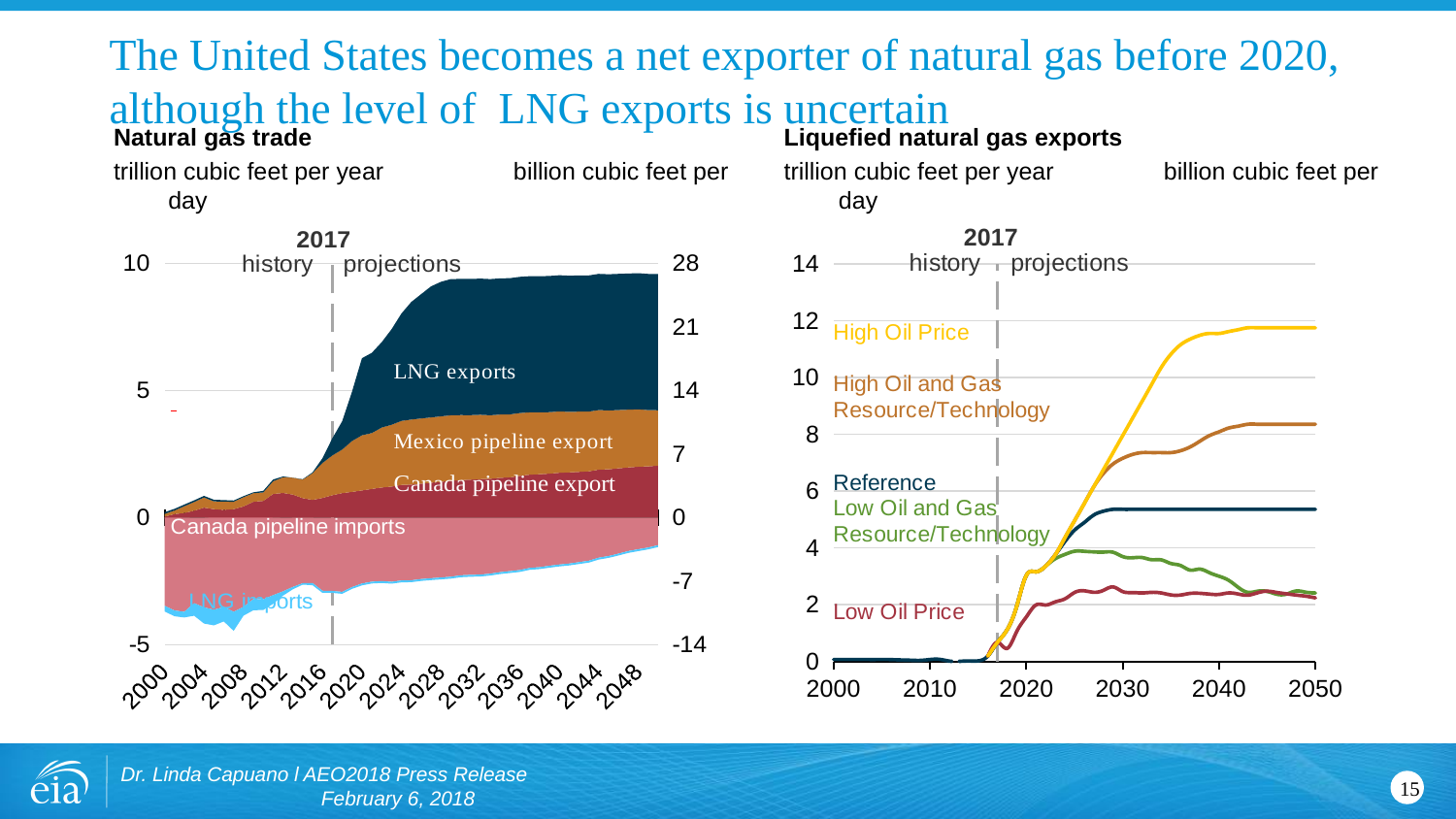
In the "Natural gas trade" chart, does the LNG exports area rise or fall after 2017? rise What kind of chart is the "Liquefied natural gas exports" chart on the right? line chart In the "Liquefied natural gas exports" chart, is the High Oil and Gas Resource/Technology value in 2050 greater or less than 6? greater How many scenario lines are plotted in the "Liquefied natural gas exports" chart? 5 In the "Liquefied natural gas exports" chart, does the High Oil Price line rise or fall between 2020 and 2040? rise In the "Natural gas trade" chart, which export category is the largest in 2048? LNG exports In the "Natural gas trade" chart, what year does the dashed line separating history from projections mark? 2017 In the "Liquefied natural gas exports" chart, which is larger in 2050: Reference or Low Oil Price? Reference In the "Liquefied natural gas exports" chart, is the Low Oil Price value in 2050 greater or less than 4? less What kind of chart is the "Natural gas trade" chart on the left? stacked area chart In the "Liquefied natural gas exports" chart, which scenario has the highest value in 2050? High Oil Price In the "Liquefied natural gas exports" chart, is the High Oil Price value in 2050 greater or less than 10? greater